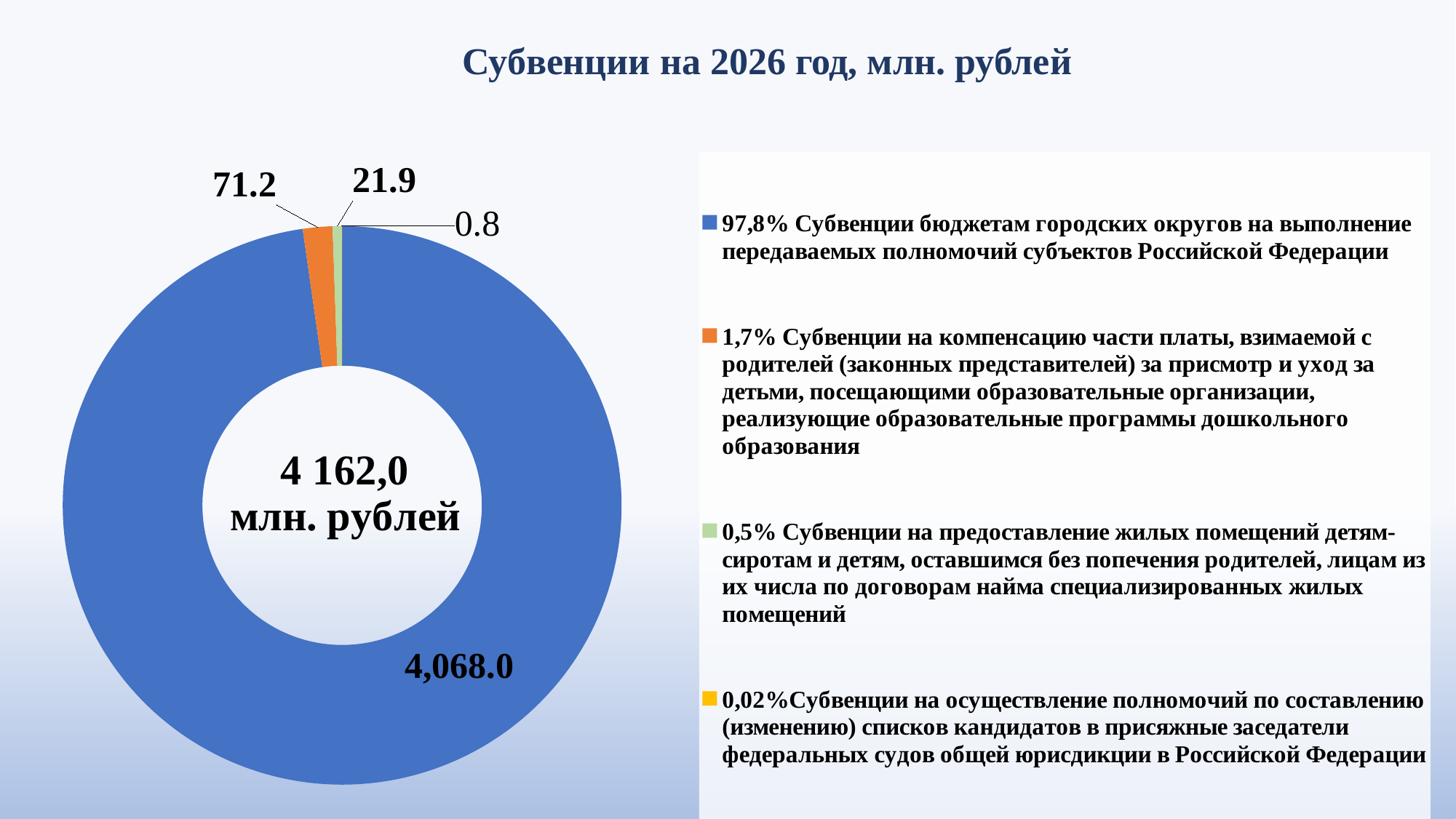
What is the difference between the value for 'Субвенции на компенсацию части платы...' (71.2) and the value for 'Субвенции на предоставление жилых помещений детям-сиротам...' (21.9)? 49.3 What is the title of the chart? Субвенции на 2026 год, млн. рублей Which category has the largest value in the chart? Субвенции бюджетам городских округов на выполнение передаваемых полномочий субъектов Российской Федерации What value is shown for the slice 'Субвенции на осуществление полномочий по составлению (изменению) списков кандидатов в присяжные заседатели...'? 0.8 What total value is shown in the centre of the doughnut? 4 162,0 млн. рублей How many categories does the chart show? 4 What kind of chart is shown on the slide? doughnut (pie) chart What value is shown for the blue slice, 'Субвенции бюджетам городских округов на выполнение передаваемых полномочий субъектов Российской Федерации'? 4,068.0 Which category has the smallest value in the chart? Субвенции на осуществление полномочий по составлению (изменению) списков кандидатов в присяжные заседатели федеральных судов общей юрисдикции в Российской Федерации What value is shown for the orange slice, 'Субвенции на компенсацию части платы, взимаемой с родителей...'? 71.2 What value is shown for the green slice, 'Субвенции на предоставление жилых помещений детям-сиротам...'? 21.9 What share of the total do the 'Субвенции бюджетам городских округов...' make up, according to the legend? 97,8%